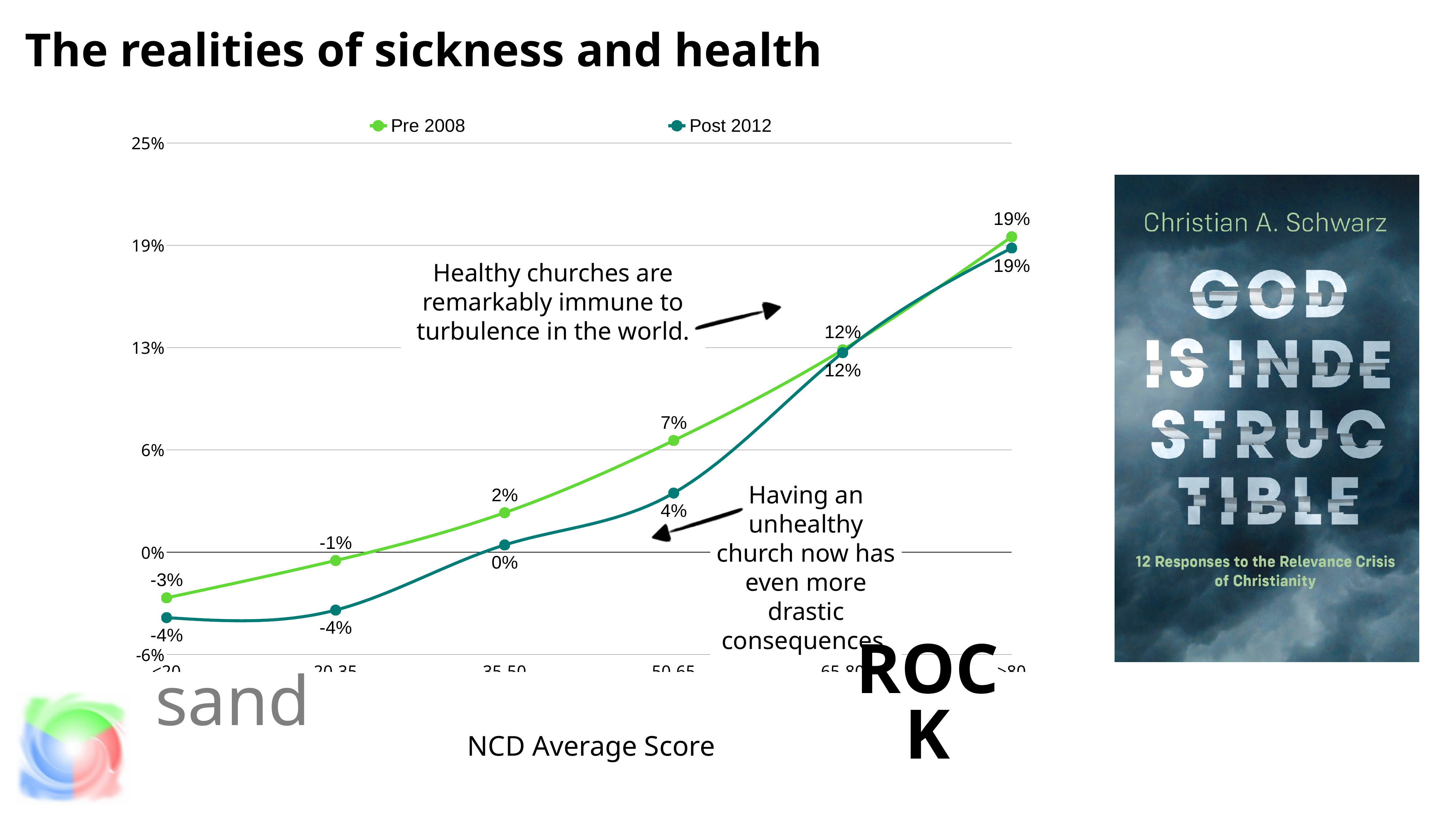
In the 35-50 category, which series has the higher value, Pre 2008 or Post 2012? Pre 2008 How many series does the chart's legend list? 2 What is the Post 2012 value for the 50-65 category? 4% What is the Post 2012 value for the 35-50 category? 0% What kind of chart is shown on the slide? Line chart What is the lowest value shown for the Post 2012 series? -4% What is the title of the x axis? NCD Average Score What is the highest value shown for the Pre 2008 series? 19% How many categories are plotted along the x axis? 6 In the 50-65 category, how many percentage points higher is Pre 2008 than Post 2012? 3 percentage points What is the Pre 2008 value for the 35-50 category? 2% What are the two series named in the legend? Pre 2008 and Post 2012